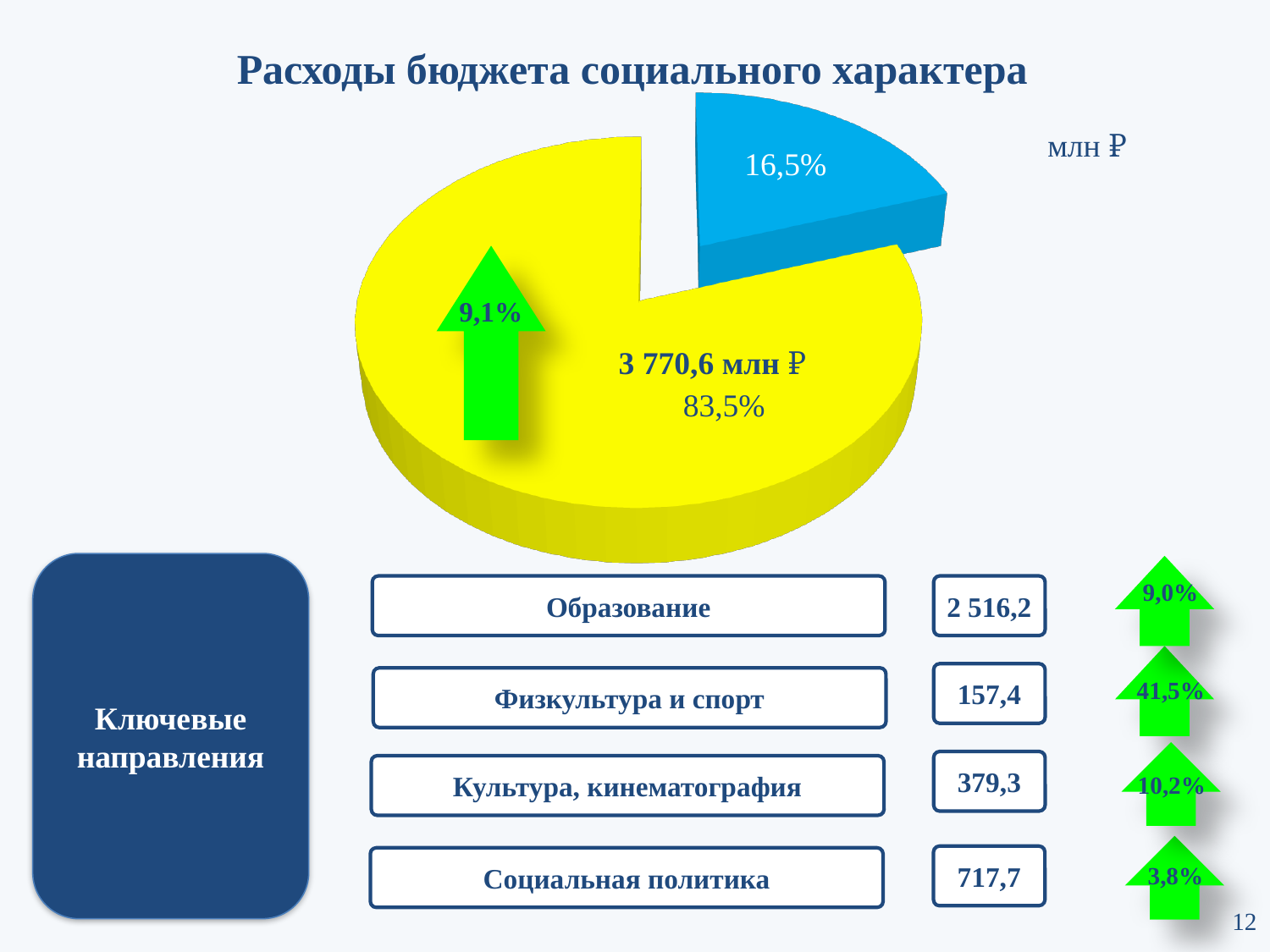
What is the title of the chart on the slide? Расходы бюджета социального характера What growth percentage is shown on the green arrow inside the yellow slice? 9,1% What kind of chart is shown on the slide? pie chart What share of the pie does the yellow slice represent? 83,5% How many slices does the pie chart have? 2 Which slice of the pie chart is larger, the yellow one or the blue one? the yellow one Which slice of the pie chart is the smallest? the blue slice (16,5%) What is the difference in percentage points between the yellow slice and the blue slice? 67 percentage points What share of the pie does the blue slice represent? 16,5% What value in млн ₽ is printed on the yellow slice of the pie chart? 3 770,6 млн ₽